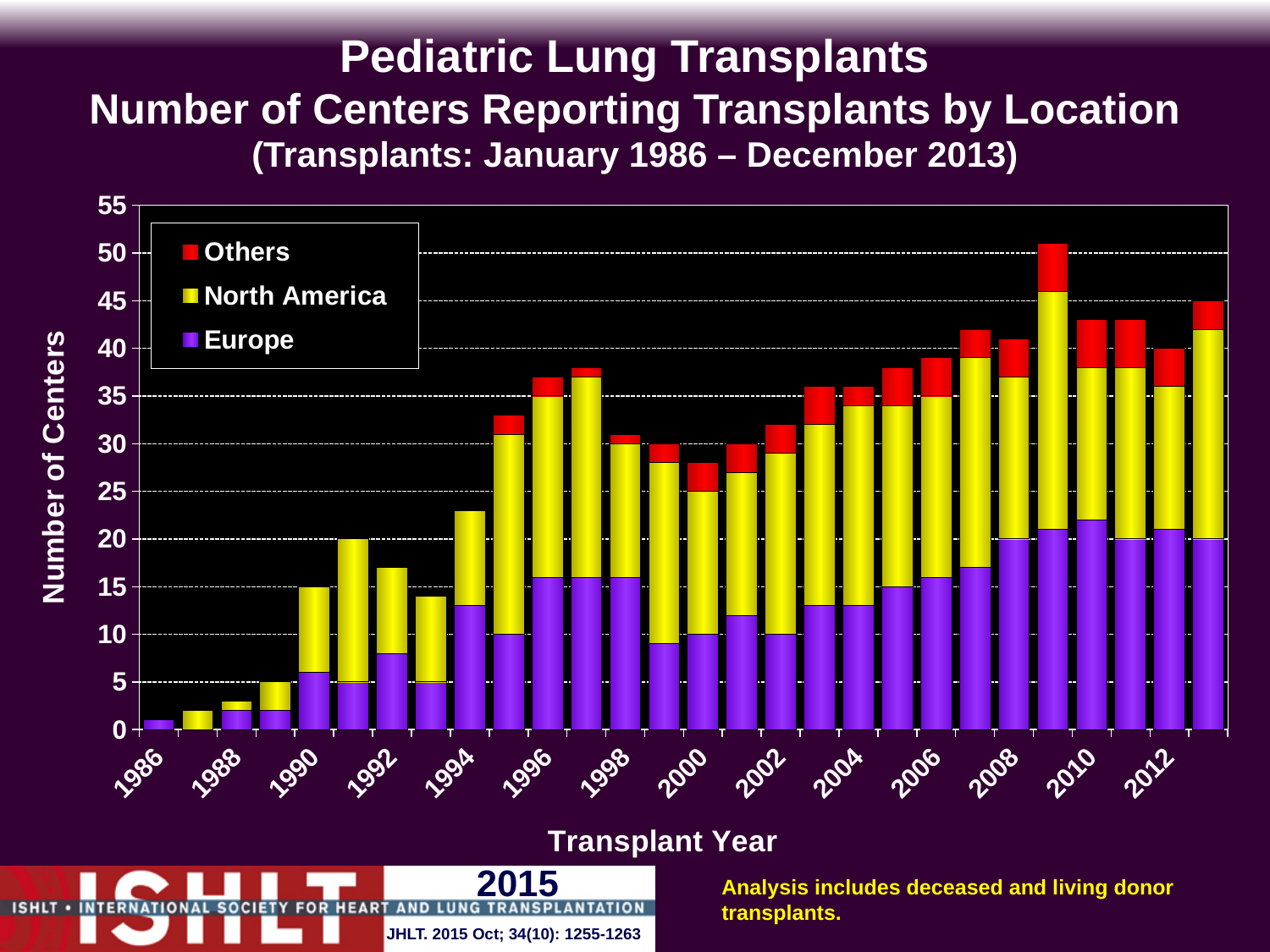
Is the number of Europe centers in 1999 greater or less than 10? less What is the title of the y axis? Number of Centers Which year has the highest total number of centers? 2009 Is the total number of centers for 1990 greater or less than 20? less Is the total number of centers for 1995 greater or less than 30? greater Which series is shown in purple in the legend? Europe Which year has the lowest total number of centers? 1986 How many series does the legend list? 3 Do the total numbers of centers rise or fall from 1986 to 1991? rise What kind of chart is shown on the slide? Stacked bar chart